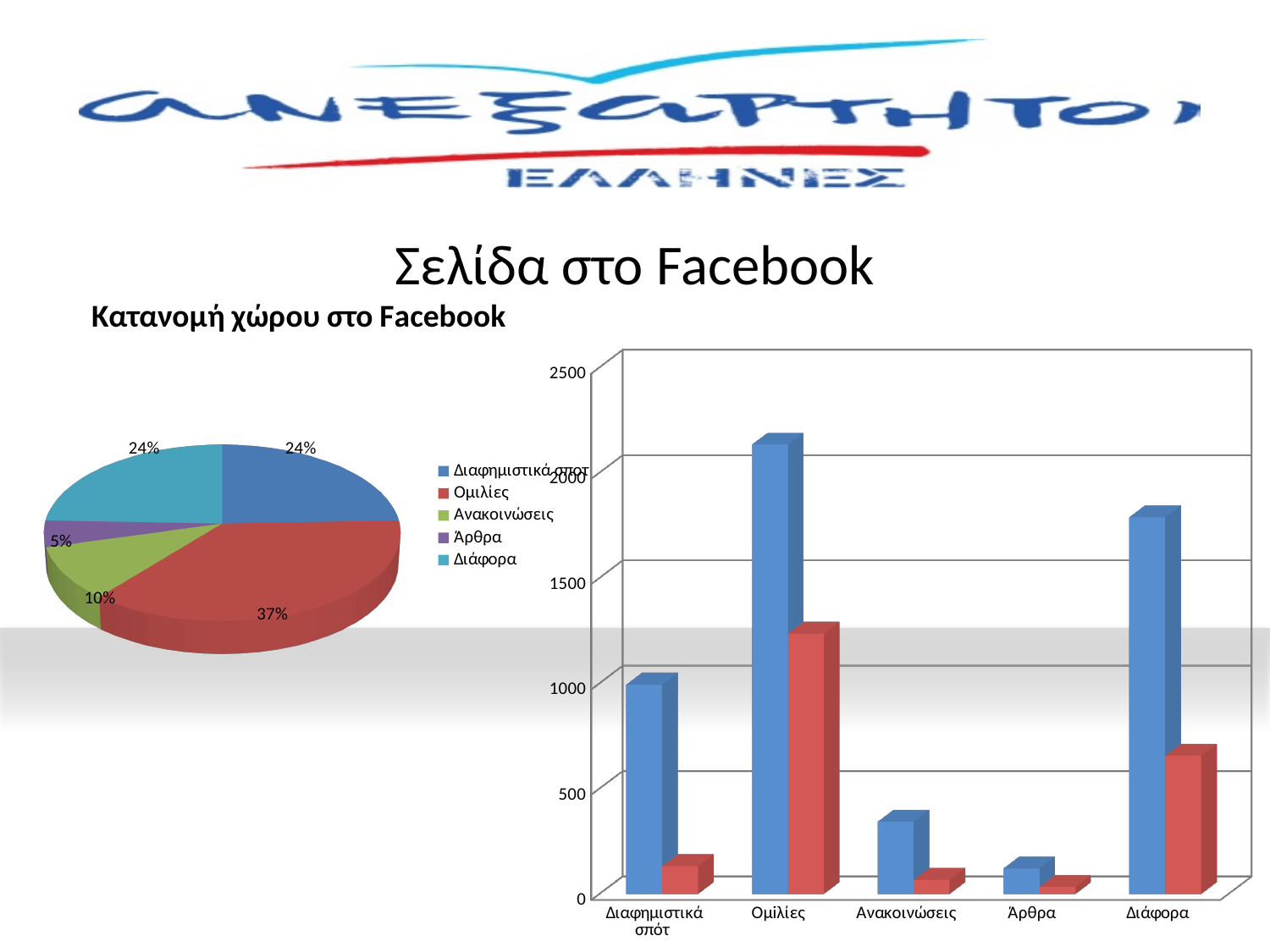
In the bar chart on the right of the slide, is the blue bar for Διάφορα taller than the blue bar for Διαφημιστικά σποτ? Yes In the pie chart titled 'Κατανομή χώρου στο Facebook', what share does Ομιλίες have? 37% What kind of chart is the chart on the right of the slide? Bar chart In the pie chart titled 'Κατανομή χώρου στο Facebook', which category has the largest slice? Ομιλίες In the pie chart titled 'Κατανομή χώρου στο Facebook', how many percentage points larger is Ομιλίες than Ανακοινώσεις? 27 In the pie chart titled 'Κατανομή χώρου στο Facebook', which category has the smallest slice? Άρθρα In the bar chart on the right of the slide, which category has the tallest blue bar? Ομιλίες In the pie chart titled 'Κατανομή χώρου στο Facebook', what share does Άρθρα have? 5% What kind of chart is the chart on the left of the slide? Pie chart In the bar chart on the right of the slide, how many categories are shown on the x axis? 5 In the bar chart on the right of the slide, is the blue bar for Ομιλίες greater or less than 2000? greater In the pie chart titled 'Κατανομή χώρου στο Facebook', how many slices are there? 5